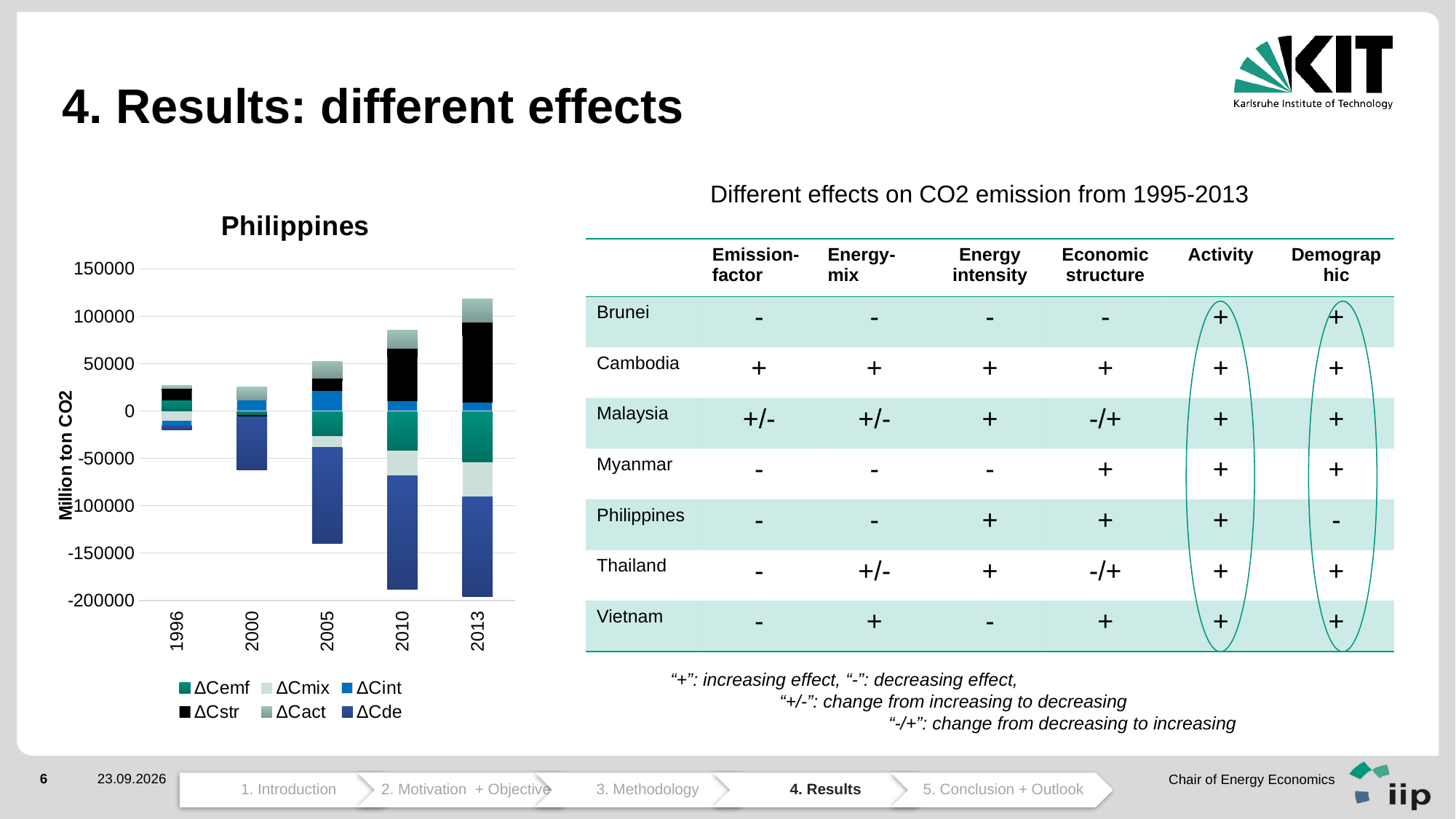
Is the top of the positive stack for 2010 greater or less than 100000? less How many years are shown on the x axis of the chart? 5 Does the height of the positive part of the stacked bars rise or fall from 1996 to 2013? rise What is the label of the vertical axis of the chart? Million ton CO2 What is the title of the chart? Philippines Is the ΔCstr value for 2013 greater or less than 50000? greater How many series does the chart's legend list? 6 Is the ΔCstr value for 2005 greater or less than 50000? less What kind of chart is shown on the slide? Stacked bar chart